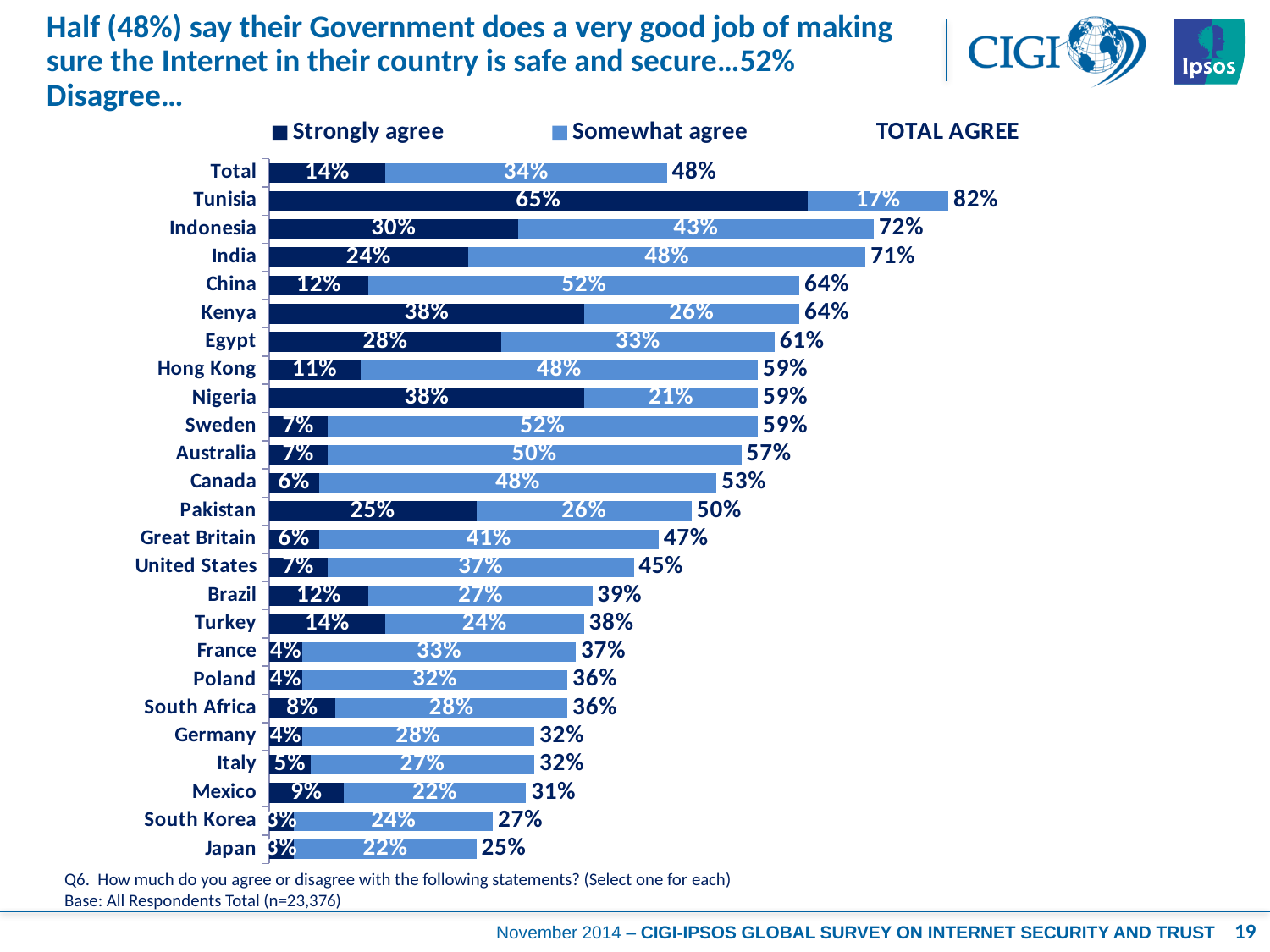
What kind of chart is shown on the slide? Stacked bar chart Which country has the highest total agree value? Tunisia Which country has the lowest total agree value? Japan What percentage of respondents in Tunisia strongly agree? 65% What is the total agree value for Pakistan? 50% What is the total of the stacked bar for Indonesia? 72% Which has a larger Strongly agree value, Kenya or Egypt? Kenya How many series does the legend list? 2 Which series is shown in dark navy blue in the legend? Strongly agree How many countries or regions (including Total) are listed on the chart? 25 What is the difference between the total agree values for Tunisia and Japan? 57% What is the Somewhat agree value for China? 52%